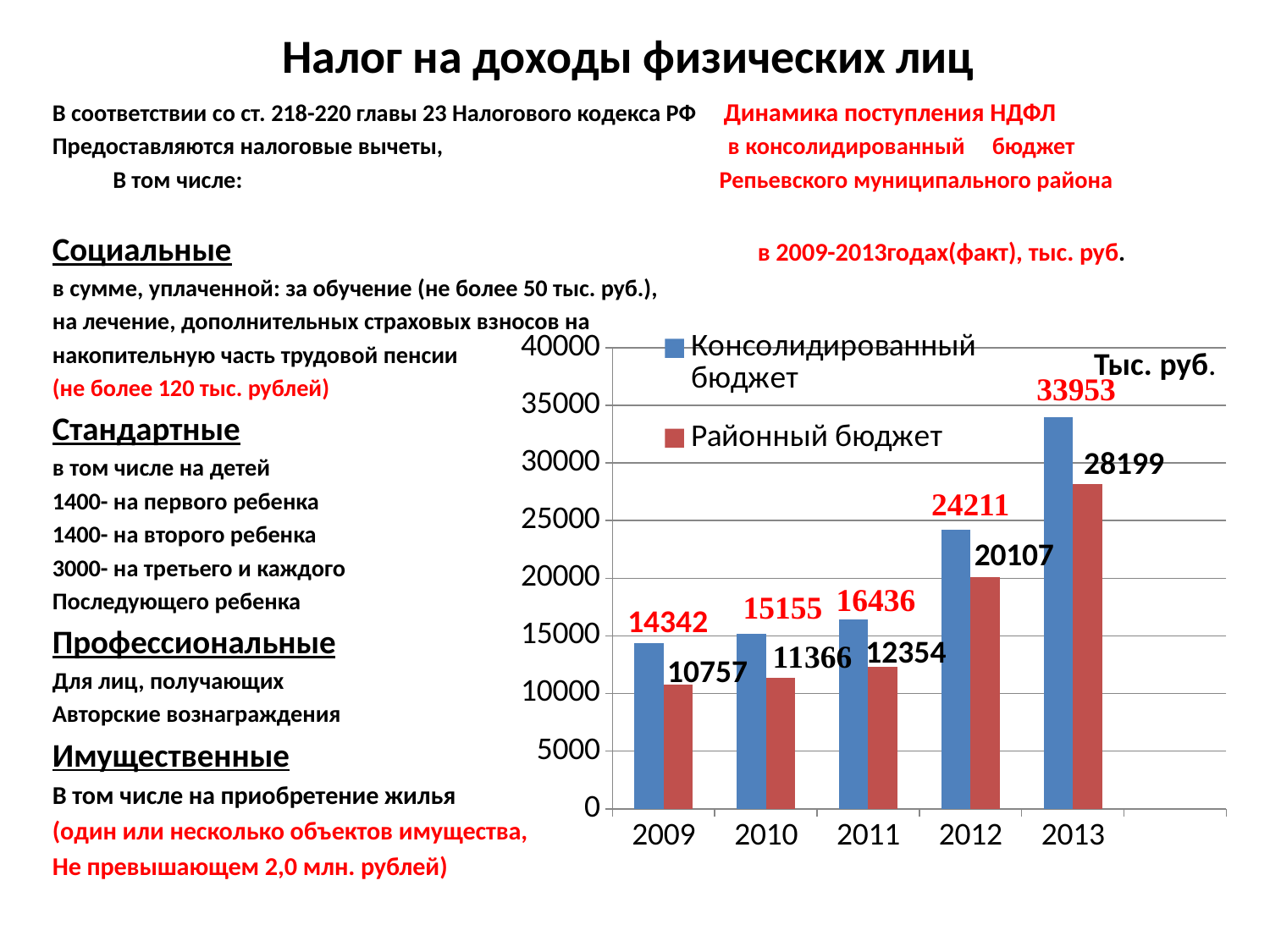
What is the value for Консолидированный бюджет in 2011? 16436 Does Районный бюджет rise or fall from 2009 to 2013? rise What is the value for Консолидированный бюджет in 2013? 33953 How many series does the legend list? 2 What is the value for Районный бюджет in 2009? 10757 In which year is Консолидированный бюджет highest? 2013 What is the difference between Консолидированный бюджет and Районный бюджет in 2013? 5754 How many years are shown on the x axis? 5 What is the value for Районный бюджет in 2012? 20107 Which is larger in 2010: Консолидированный бюджет or Районный бюджет? Консолидированный бюджет In which year is Районный бюджет lowest? 2009 Is the value for Консолидированный бюджет in 2012 greater or less than 20000? greater